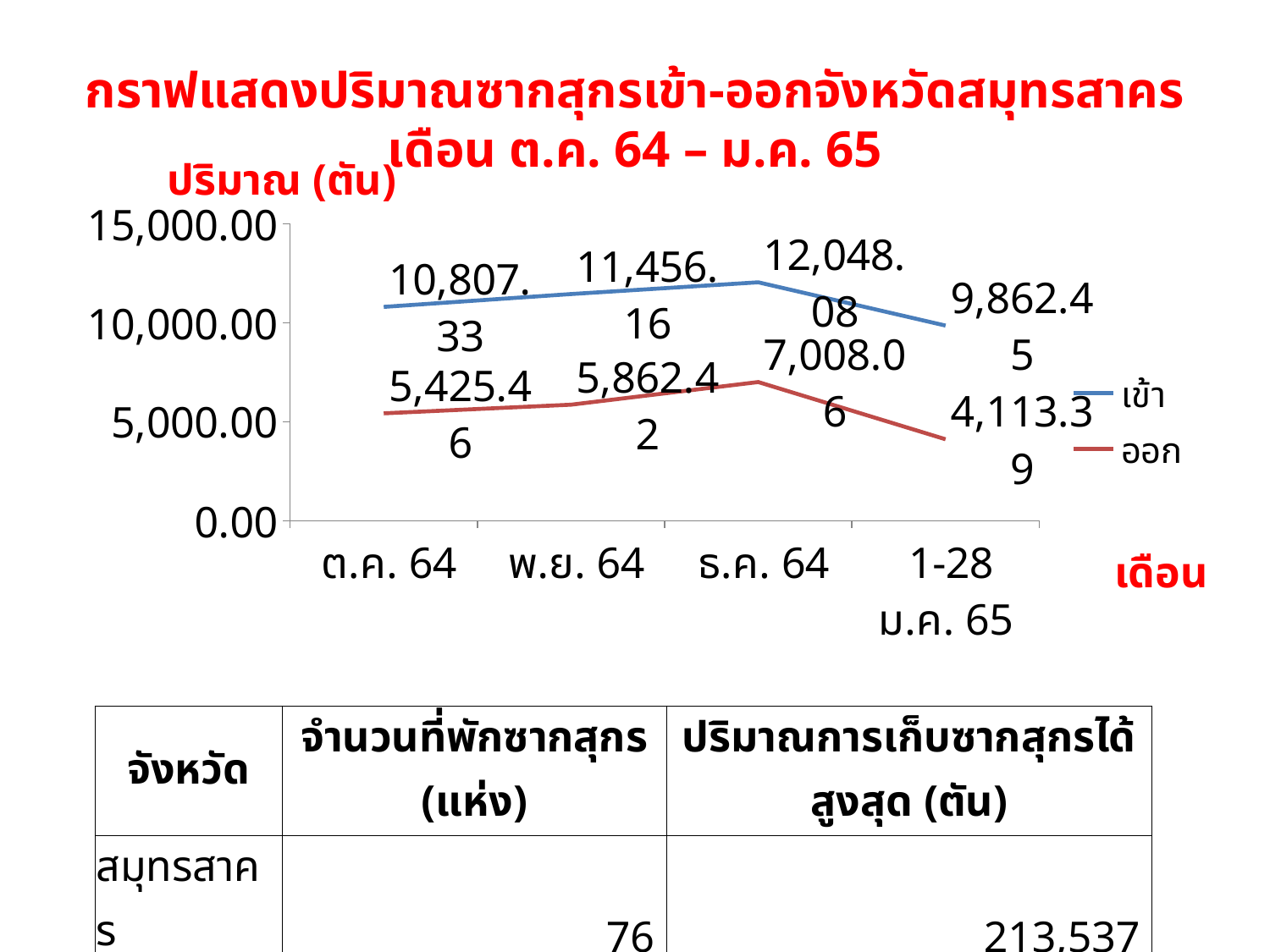
What is the value of the ออก series for ต.ค. 64? 5,425.46 What type of chart is shown on the slide? line chart How many series does the chart legend list? 2 What is the label of the y axis of the chart? ปริมาณ (ตัน) What is the difference between the เข้า and ออก values for พ.ย. 64? 5,593.74 In which month is the ออก series highest? ธ.ค. 64 What is the value of the เข้า series for 1-28 ม.ค. 65? 9,862.45 In which month is the เข้า series lowest? 1-28 ม.ค. 65 What is the value of the เข้า series for ธ.ค. 64? 12,048.08 Does the เข้า series rise or fall from ธ.ค. 64 to 1-28 ม.ค. 65? fall Which is larger: the ออก value for ธ.ค. 64 or the ออก value for พ.ย. 64? ธ.ค. 64 How many months (categories) are plotted on the x axis of the chart? 4